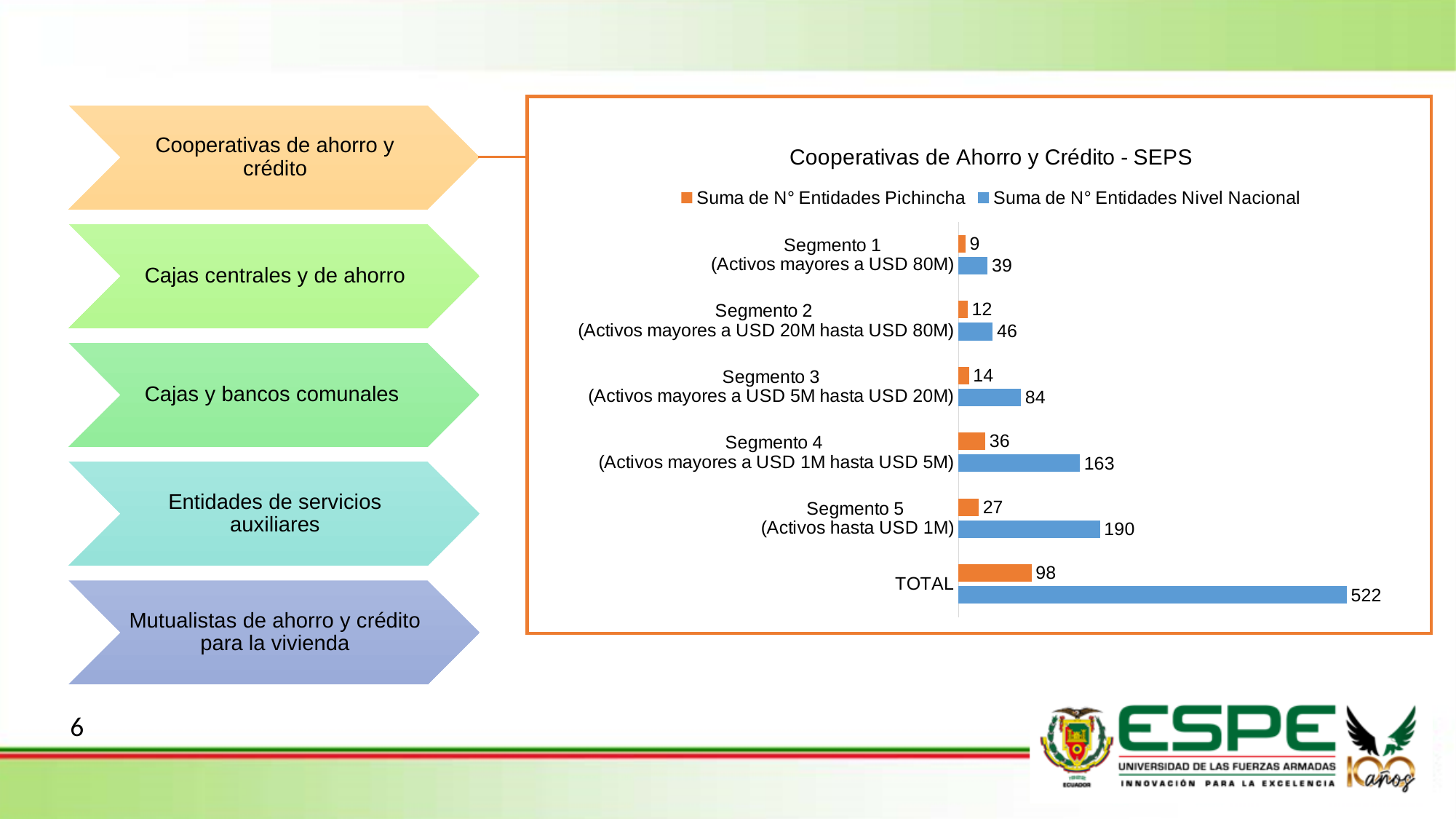
What is the title of the chart? Cooperativas de Ahorro y Crédito - SEPS What kind of chart is shown on the slide? Bar chart What is the value of Suma de N° Entidades Nivel Nacional for Segmento 3? 84 What is the value of Suma de N° Entidades Nivel Nacional for TOTAL? 522 Which colour represents Suma de N° Entidades Pichincha in the chart? Orange What is the difference between the Nivel Nacional and Pichincha values for Segmento 5? 163 Excluding TOTAL, which segment has the lowest value for Suma de N° Entidades Pichincha? Segmento 1 Excluding TOTAL, which segment has the highest value for Suma de N° Entidades Nivel Nacional? Segmento 5 What is the value of Suma de N° Entidades Pichincha for Segmento 4? 36 How many categories are shown on the chart, including TOTAL? 6 Which is larger: the Pichincha value for Segmento 4 or the Pichincha value for Segmento 5? Segmento 4 How many series does the legend list? 2